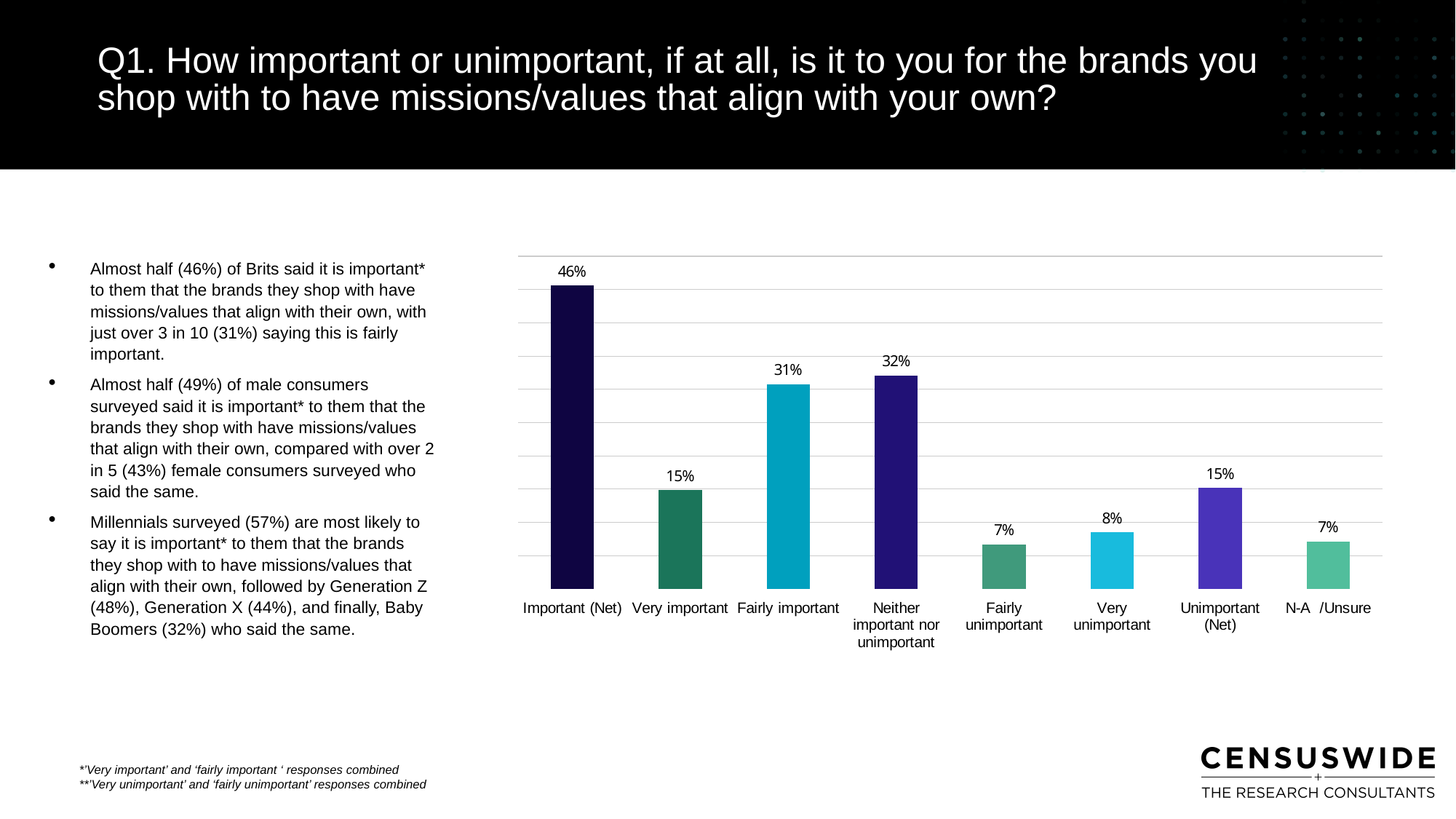
Which category has the highest value? Important (Net) What is the value for Unimportant (Net)? 15% What is the value for Very unimportant? 8% Which is larger, Neither important nor unimportant or Fairly important? Neither important nor unimportant How many categories are shown on the x axis? 8 What kind of chart is shown on the slide? Bar chart What is the value for Neither important nor unimportant? 32% What is the value for Important (Net)? 46% What is the difference between Fairly important and Very important? 16% Which is larger, Very unimportant or Fairly unimportant? Very unimportant What is the difference between Important (Net) and Unimportant (Net)? 31%